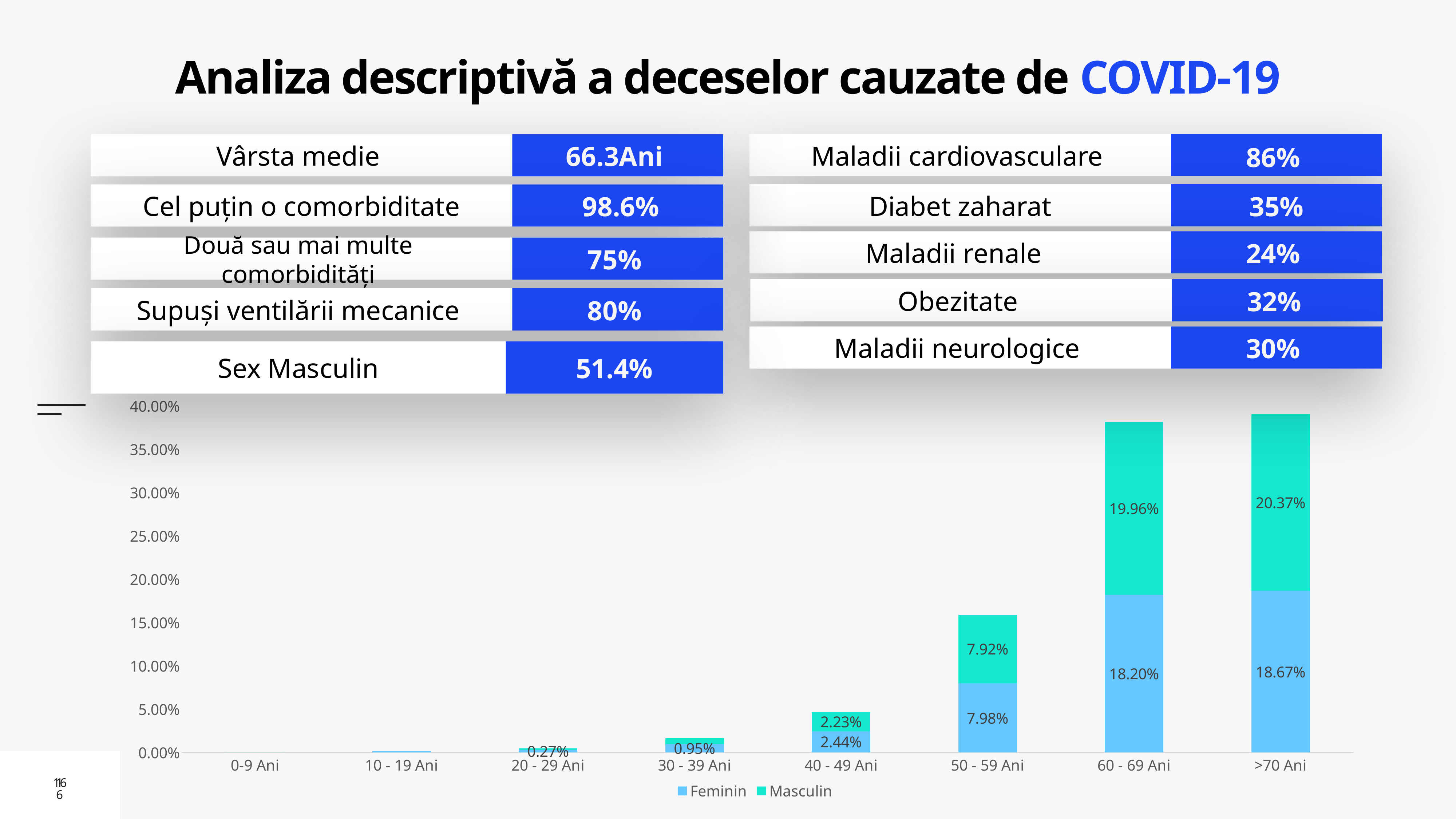
Which age group has the highest Masculin value? >70 Ani What is the Masculin value for the 50 - 59 Ani age group? 7.92% What is the difference between the Masculin and Feminin values for the 60 - 69 Ani age group? 1.76% Is the total stacked bar for the 60 - 69 Ani age group greater or less than 40.00%? less What is the Feminin value for the 40 - 49 Ani age group? 2.44% What is the Feminin value for the 60 - 69 Ani age group? 18.20% In the 40 - 49 Ani age group, which is larger, the Feminin or the Masculin value? Feminin What is the total of the stacked bar for the 50 - 59 Ani age group? 15.90% What is the Masculin value for the >70 Ani age group? 20.37% What kind of chart is shown on the slide? Stacked bar chart How many age groups are shown on the x axis of the chart? 8 How many series does the chart legend list? 2